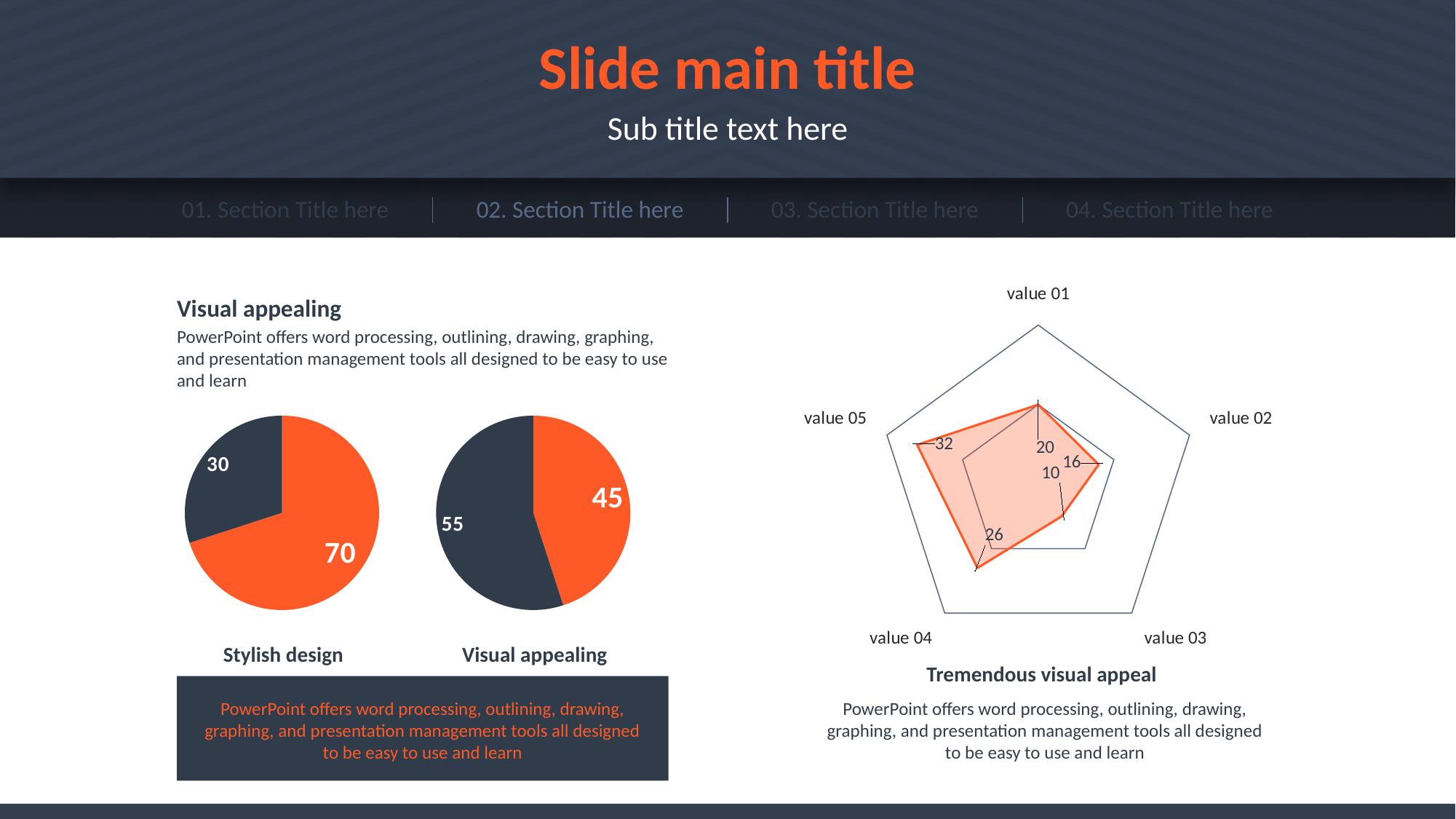
What kind of chart is the 'Stylish design' chart? pie chart In the 'Stylish design' pie chart, what is the value of the orange slice? 70 In the 'Stylish design' pie chart, what is the value of the dark slice? 30 In the 'Stylish design' pie chart, what share of the pie does the orange slice represent? 70% In the radar chart on the right, which category has the lowest value? value 03 In the 'Visual appealing' pie chart, what is the difference between the two slice values? 10 In the radar chart on the right, how many categories are plotted? 5 In the radar chart on the right, what is the value for value 01? 20 In the radar chart on the right, which category has the highest value? value 05 In the radar chart on the right, what is the value for value 04? 26 In the 'Visual appealing' pie chart, which slice is larger, the orange one or the dark one? the dark one In the 'Visual appealing' pie chart, what is the value of the dark slice? 55